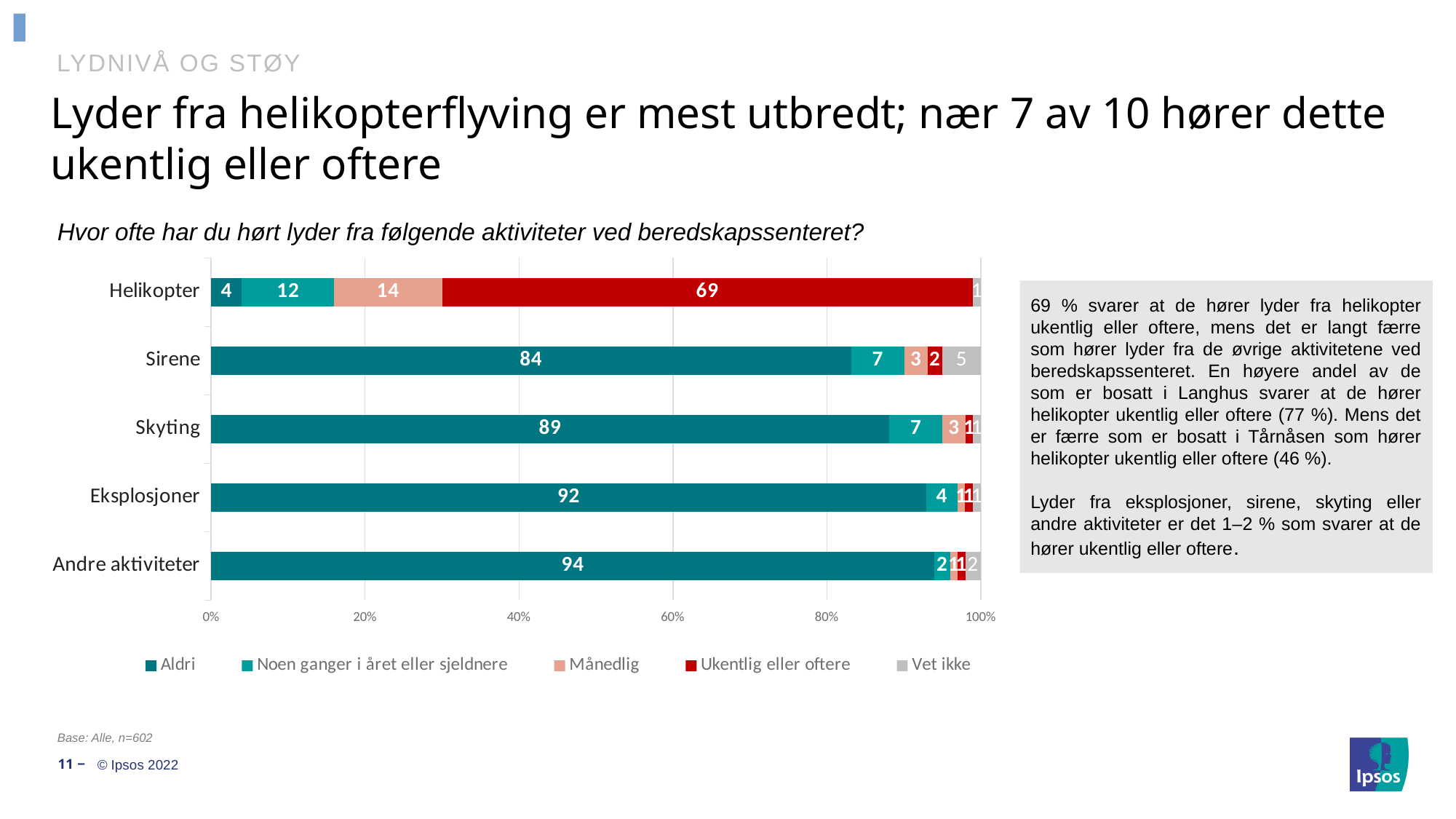
Which is larger: the 'Noen ganger i året eller sjeldnere' value for Helikopter or for Sirene? Helikopter What is the 'Månedlig' value for Helikopter? 14 Which category has the lowest 'Aldri' value? Helikopter What is the 'Aldri' value for Sirene? 84 What percentage of respondents say they hear sounds from Helikopter 'Ukentlig eller oftere'? 69 Which legend entry is shown in red? Ukentlig eller oftere Which category has the highest 'Aldri' value? Andre aktiviteter How many series does the legend list? 5 What is the 'Aldri' value for Andre aktiviteter? 94 What is the difference between the 'Aldri' values for Eksplosjoner and Skyting? 3 How many categories are shown on the y axis of the chart? 5 What kind of chart is shown on the slide? Stacked bar chart